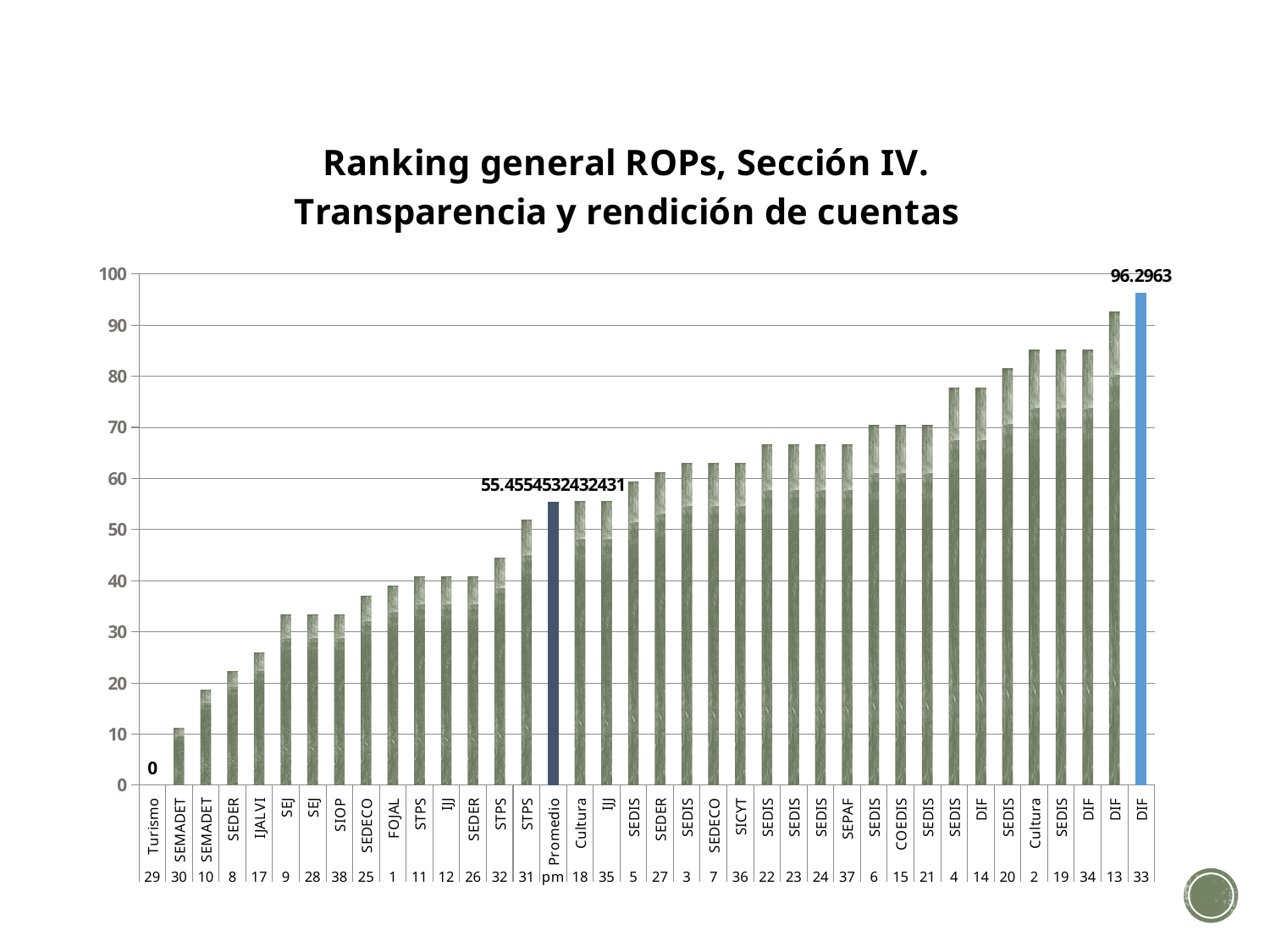
What colour is the bar for DIF 33? blue What is the value of the bar labelled Turismo 29? 0 Which bar has the lowest value? Turismo 29 Which bar has the highest value? DIF 33 What is the value of the bar labelled DIF 33? 96.2963 Is the value for SEDIS 4 greater or less than 70? greater Is the value for SEMADET 30 greater or less than 20? less Which is larger, the value for DIF 33 or the Promedio value? DIF 33 What type of chart is shown on the slide? bar chart Do the bar values rise or fall from left to right along the x axis? rise What is the value of the Promedio bar? 55.4554532432431 What is the title of the chart? Ranking general ROPs, Sección IV. Transparencia y rendición de cuentas